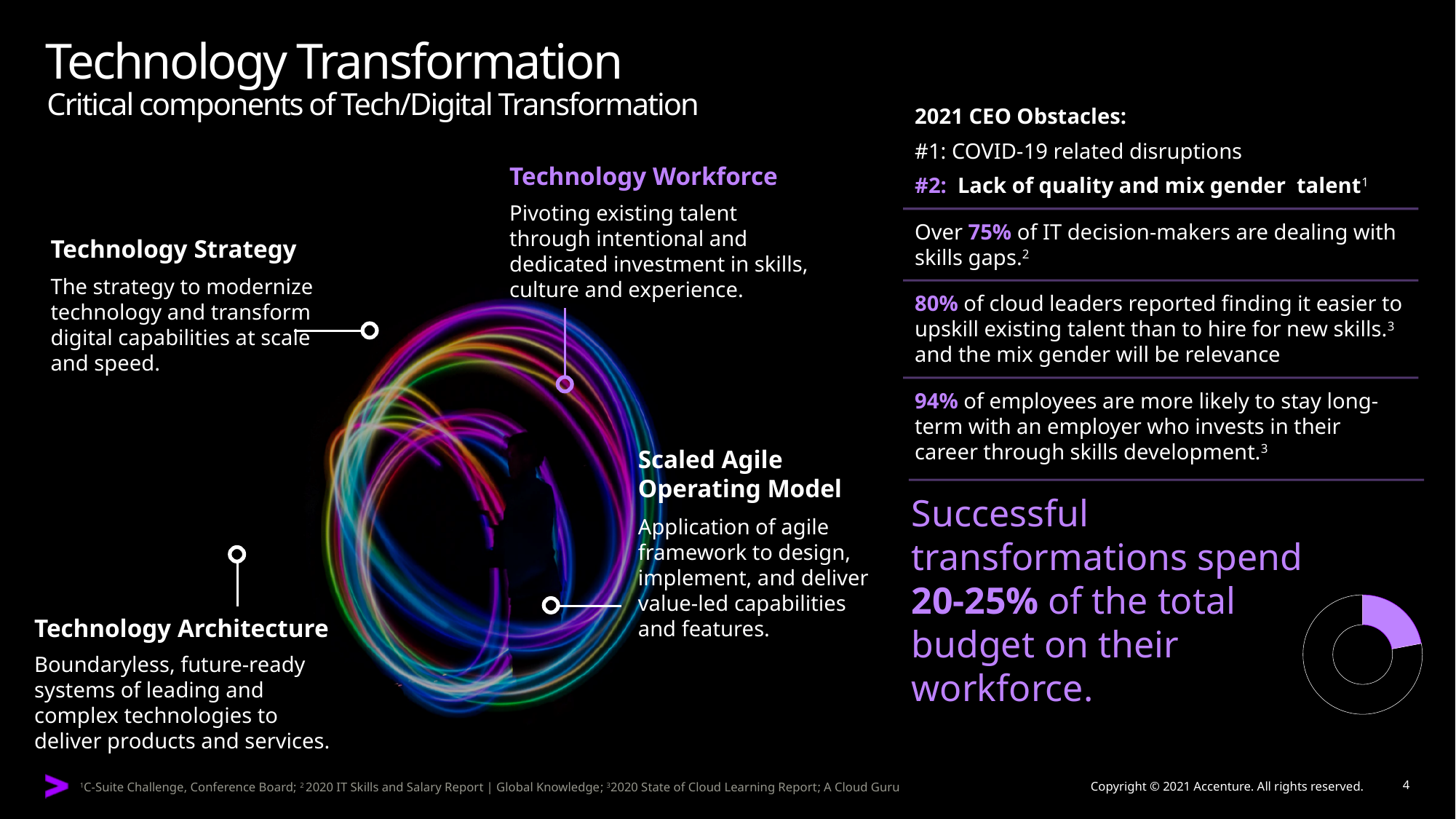
What kind of chart is shown in the bottom-right corner of the slide? Donut (pie) chart According to the text next to the donut chart, what share of the total budget do successful transformations spend on their workforce? 20-25% Does the donut chart in the bottom-right corner have a legend? No How many segments does the donut chart in the bottom-right corner have? 2 What colour is the highlighted segment of the donut chart in the bottom-right corner? Purple Is the highlighted purple segment of the donut chart larger or smaller than half of the ring? Smaller